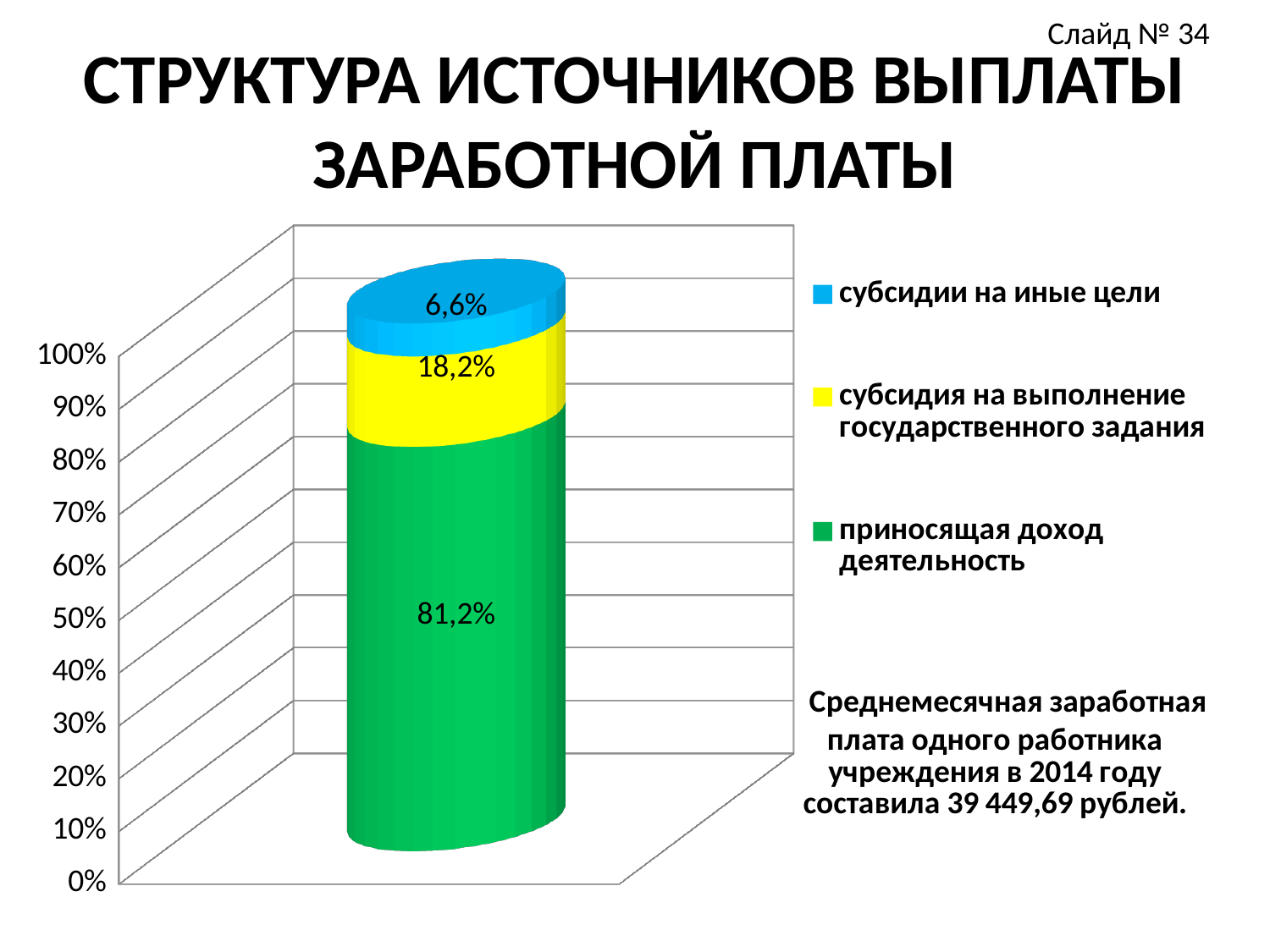
What is the difference between the values for "приносящая доход деятельность" and "субсидия на выполнение государственного задания"? 63,0% What is the title of the chart on the slide? СТРУКТУРА ИСТОЧНИКОВ ВЫПЛАТЫ ЗАРАБОТНОЙ ПЛАТЫ Which is larger: the value for "субсидия на выполнение государственного задания" or the value for "субсидии на иные цели"? субсидия на выполнение государственного задания What colour represents "приносящая доход деятельность" in the chart? green Which source has the smallest share of the bar? субсидии на иные цели What is the difference between the values for "субсидия на выполнение государственного задания" and "субсидии на иные цели"? 11,6% Which source has the largest share of the bar? приносящая доход деятельность What is the value shown for "субсидии на иные цели"? 6,6% What is the value shown for "субсидия на выполнение государственного задания"? 18,2% What is the value shown for "приносящая доход деятельность"? 81,2% What kind of chart is shown on the slide? stacked bar chart How many series does the legend list? 3